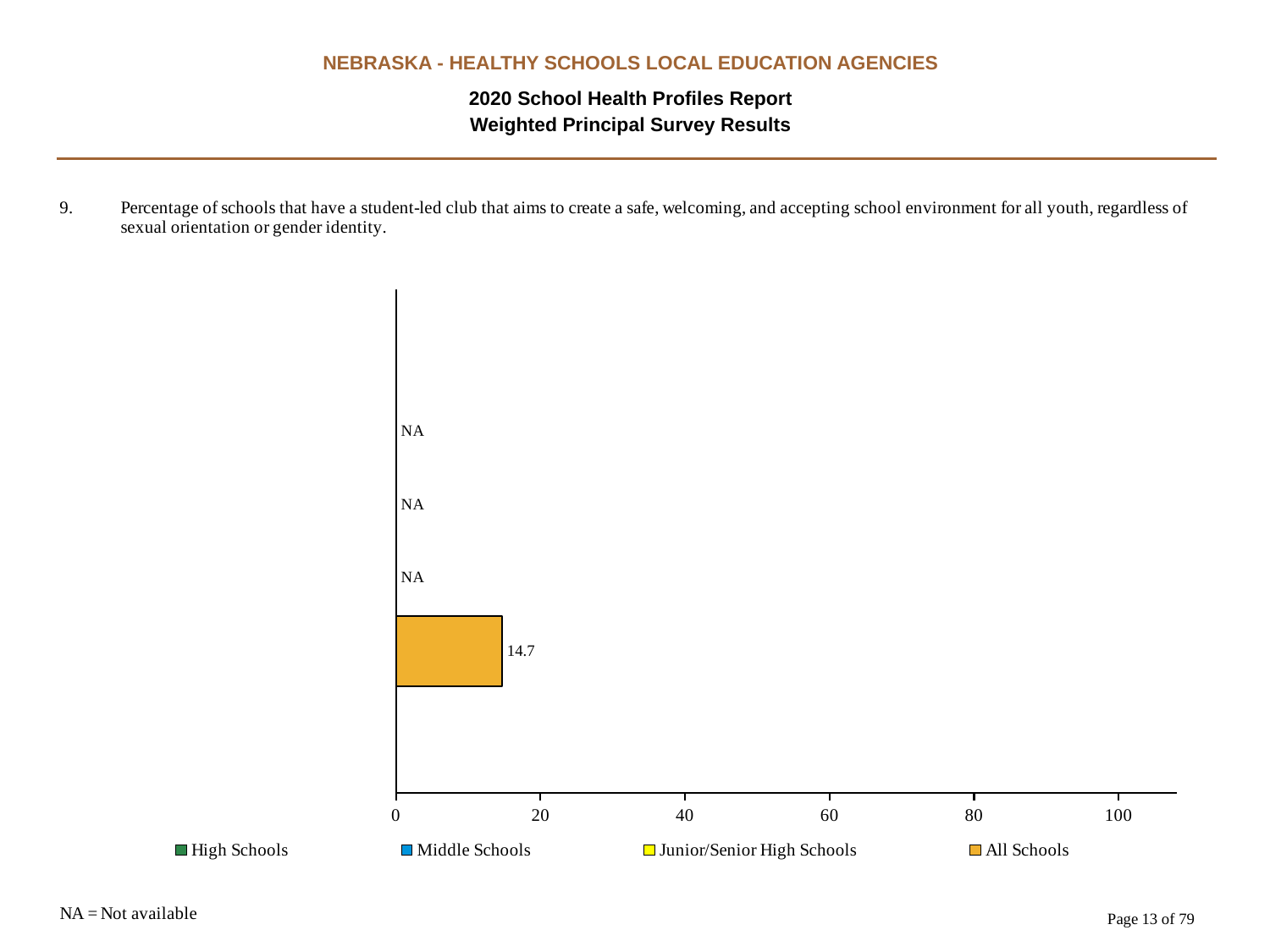
Which series is the only one with a plotted bar? All Schools What kind of chart is shown on the slide? bar chart Is the value for All Schools greater or less than 10? greater What is shown for Junior/Senior High Schools in the chart? NA Is the value for All Schools greater or less than 20? less What is the highest value shown on the x axis? 100 What is shown for Middle Schools in the chart? NA How many series does the legend list? 4 What is the value for All Schools? 14.7 How many series have a plotted bar with a numeric value in the chart? 1 What does NA stand for according to the note on the slide? Not available What is shown for High Schools in the chart? NA